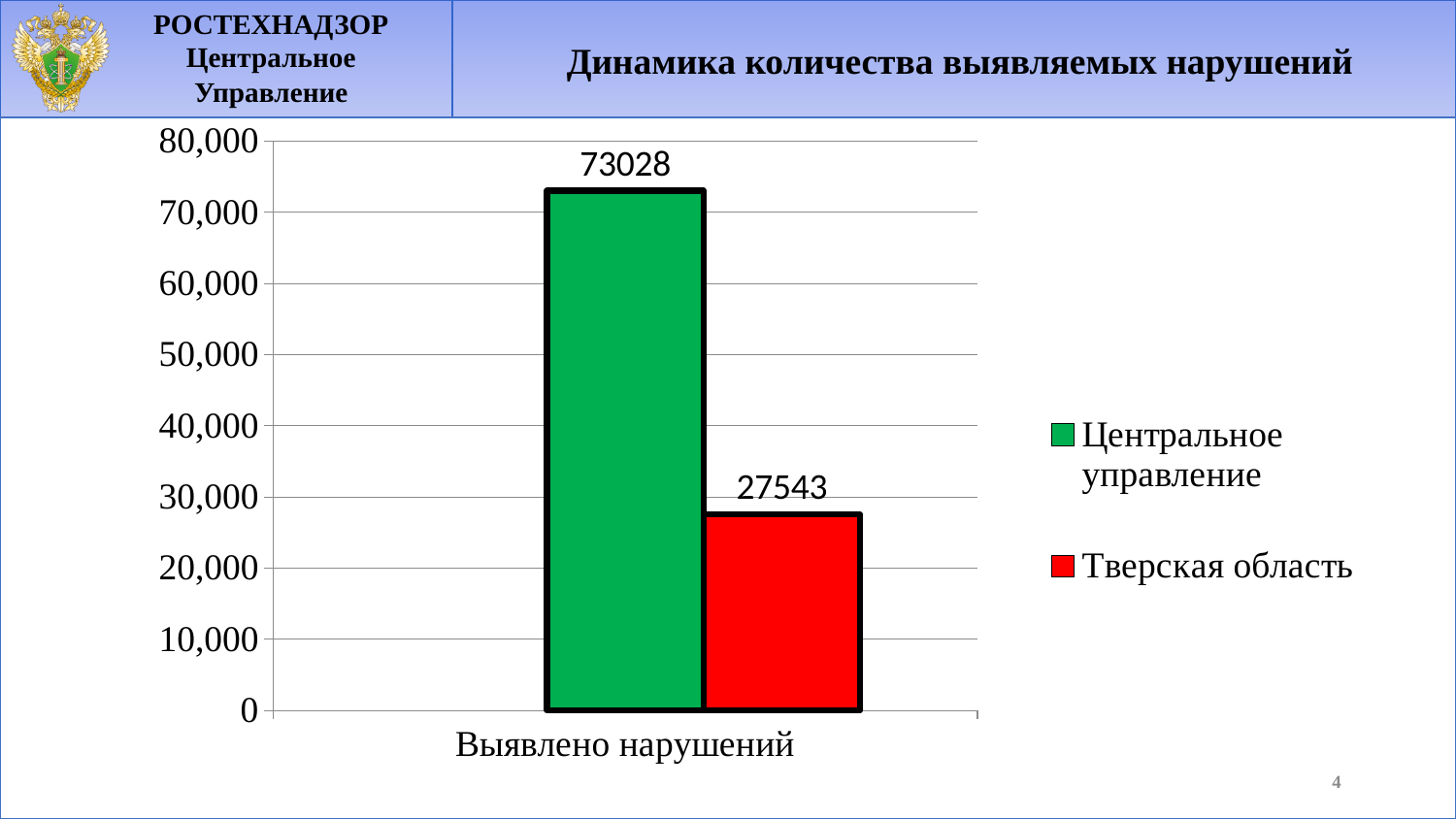
What is the value for Центральное управление in the chart? 73028 Which series has the higher value, Центральное управление or Тверская область? Центральное управление Which series has the highest value in the chart? Центральное управление How many series does the legend list? 2 Is the value for Тверская область greater or less than 30,000? less What is the difference between the values for Центральное управление and Тверская область? 45485 Which series has the lowest value in the chart? Тверская область What kind of chart is shown on the slide? bar chart What is the value for Тверская область in the chart? 27543 What colour is the bar for Тверская область? red What is the category label on the x axis of the chart? Выявлено нарушений Is the value for Центральное управление greater or less than 70,000? greater